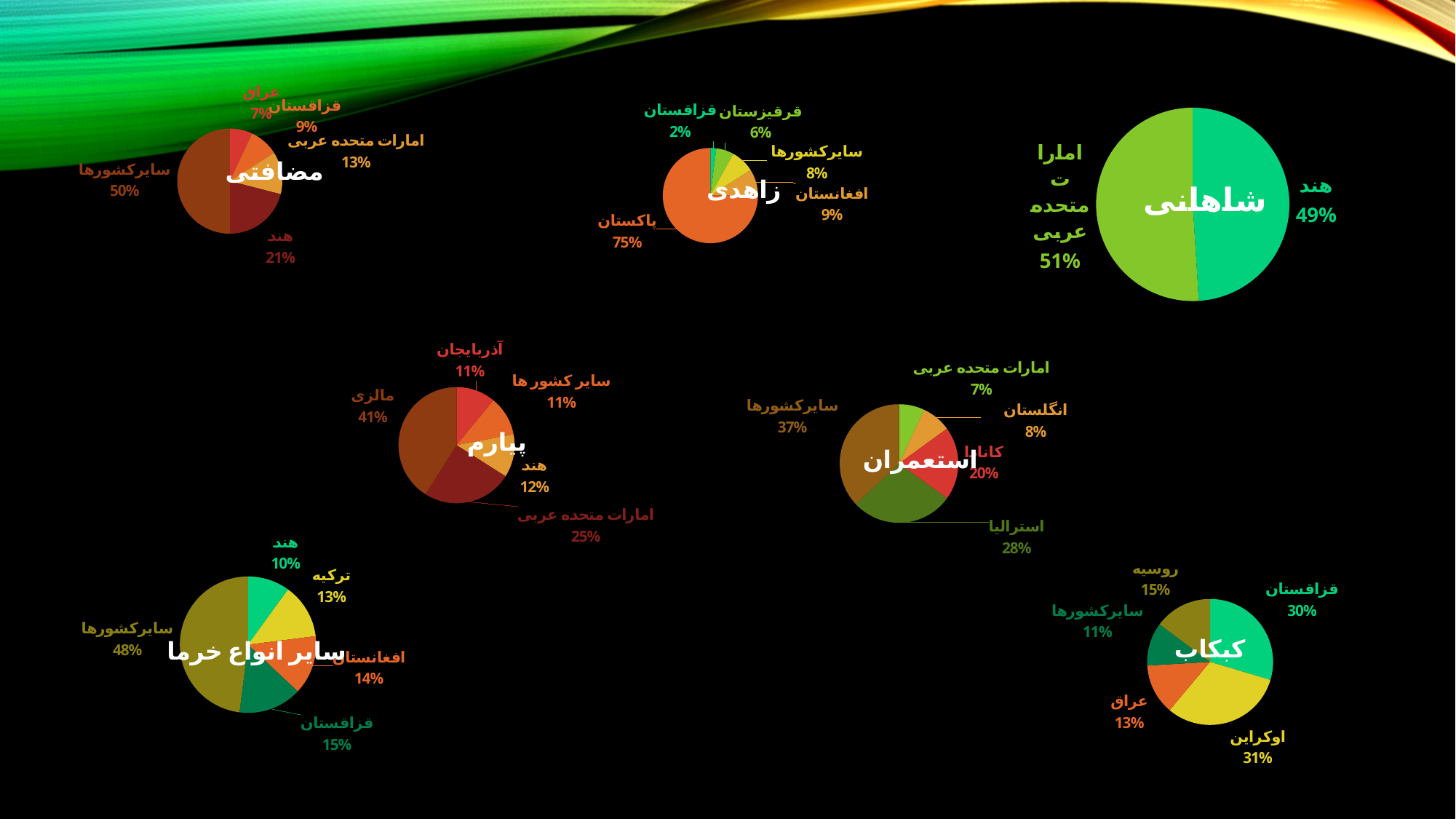
In the پیارم (Piarom) pie chart, what is the difference between the shares of مالزی (Malaysia) and امارات متحده عربی (UAE)? 16% What type of chart is used for سایر انواع خرما (other date types)? Pie chart How many pie charts are shown on the slide? 7 How many slices does the کبکاب (Kabkab) pie chart have? 5 In the زاهدی (Zahedi) pie chart, what share does پاکستان (Pakistan) have? 75% In the استعمران (Estamaran) pie chart, which is larger: استرالیا (Australia) or کانادا (Canada)? استرالیا In the زاهدی (Zahedi) pie chart, which category has the smallest share? قزاقستان In the شاهانی (Shahani) pie chart, what share does هند (India) have? 49% In the مضافتی (Mazafati) pie chart, which category has the largest share? سایرکشورها In the سایر انواع خرما pie chart, what share does ترکیه (Turkey) have? 13% In the استعمران (Estamaran) pie chart, what share does انگلستان (England) have? 8% In the کبکاب (Kabkab) pie chart, what share does اوکراین (Ukraine) have? 31%